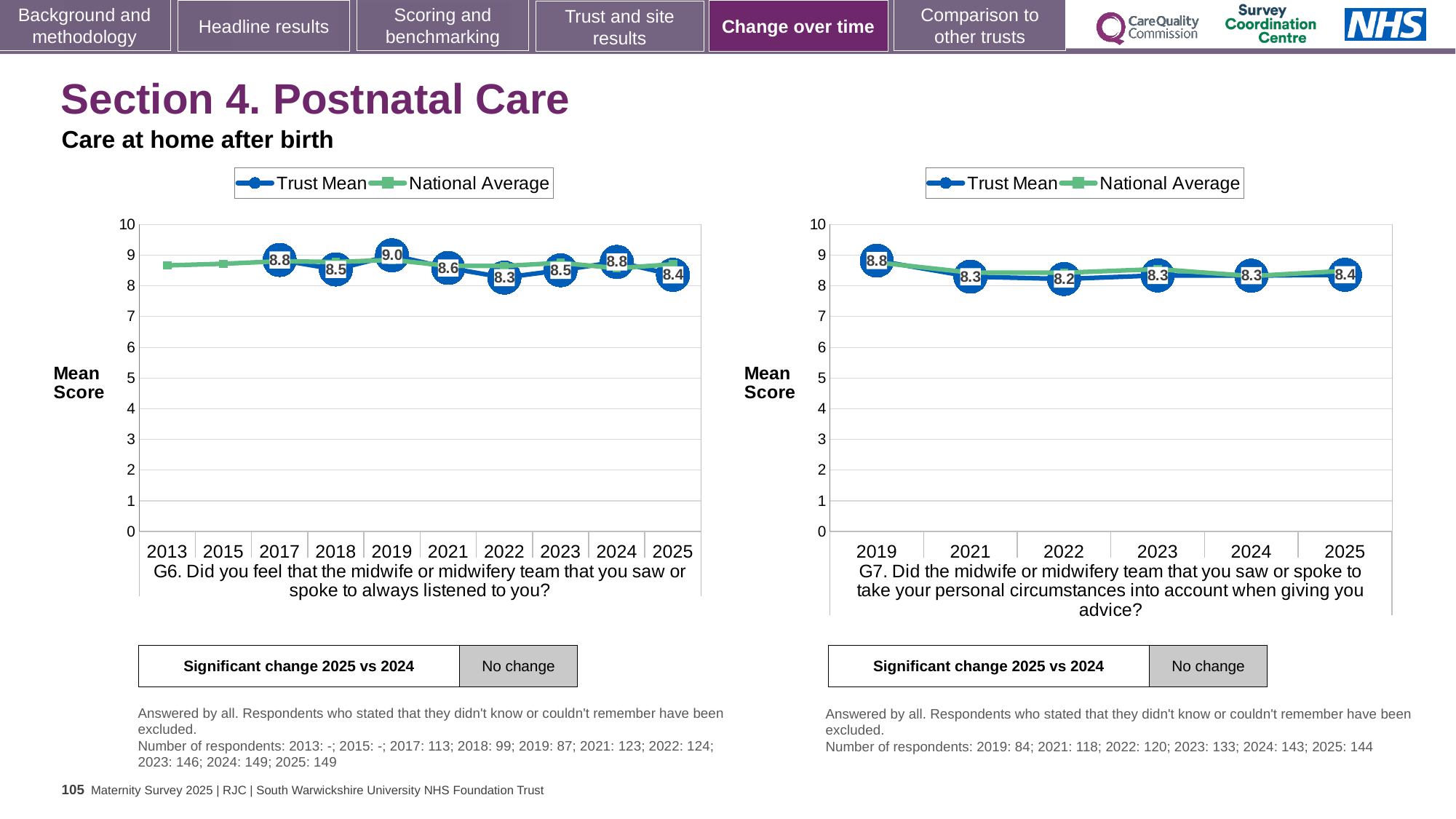
In the G6 chart on the left, what is the Trust Mean for 2019? 9.0 How many series does the legend of the G6 chart on the left list? 2 In the G7 chart on the right, is the Trust Mean for 2025 greater or less than 8? greater In the G6 chart on the left, which year has the highest Trust Mean? 2019 In the G6 chart on the left, what is the difference between the Trust Mean in 2024 and in 2025? 0.4 In the G6 chart on the left, what is the Trust Mean for 2025? 8.4 In the G6 chart on the left, which year has the lowest Trust Mean? 2022 In the G7 chart on the right, how many years are shown on the x axis? 6 What kind of chart is the G7 chart on the right? Line chart In the G7 chart on the right, is the Trust Mean for 2019 larger or smaller than the Trust Mean for 2021? larger In the G7 chart on the right, which year has the lowest Trust Mean? 2022 In the G7 chart on the right, what is the Trust Mean for 2019? 8.8